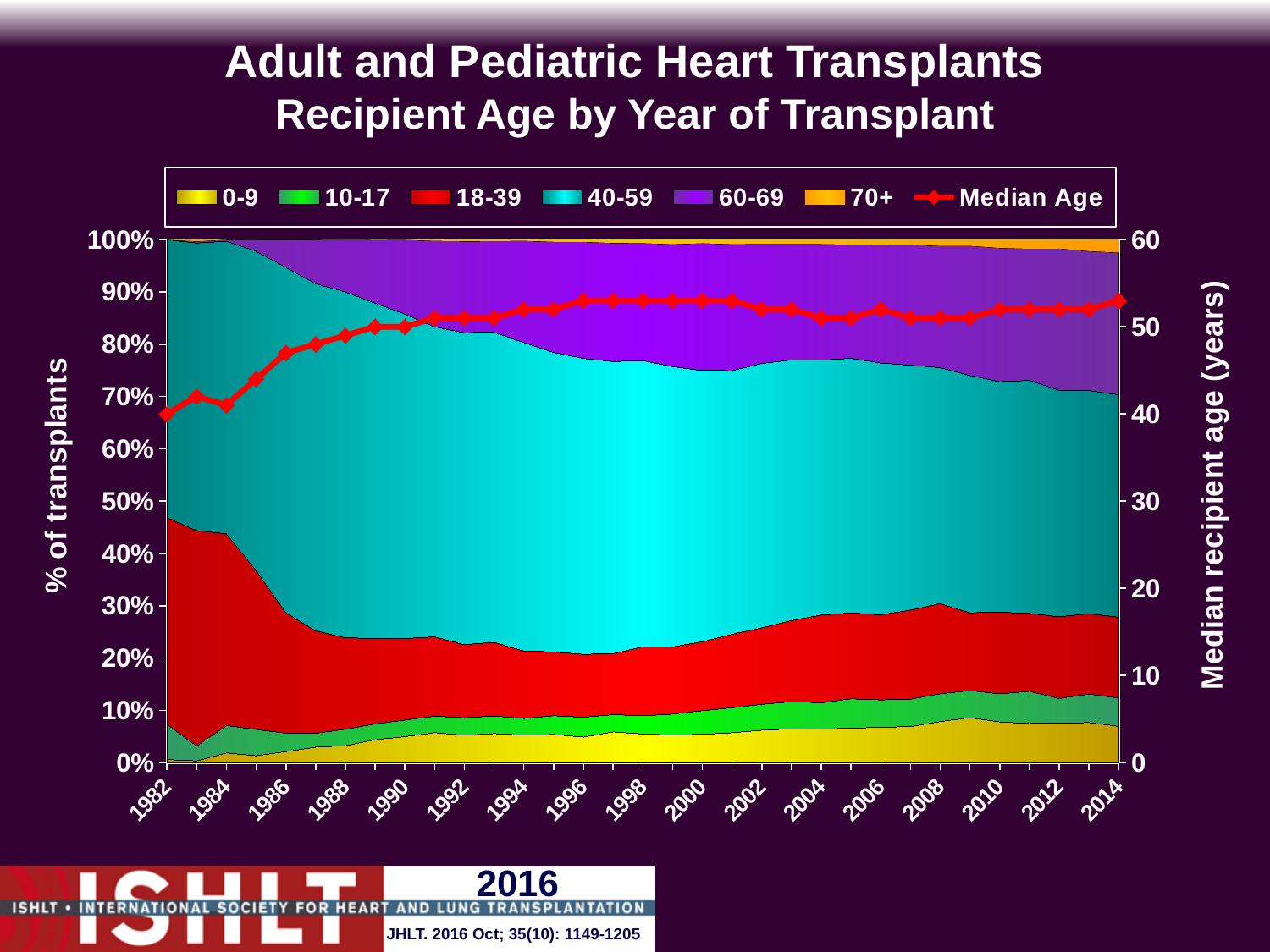
Is the median recipient age in 2014 greater or less than 50 years? greater What is the label of the right-hand vertical axis? Median recipient age (years) Does the share of transplants in the 18-39 age group rise or fall from 1982 to 2014? fall Does the median recipient age generally rise or fall from 1982 to 2014? rise Is the median recipient age in 1982 greater or less than 50 years? less What kind of chart is shown on the slide? Stacked area chart with a line for median age How many year labels are shown along the x axis? 17 Is the median recipient age in 1998 greater or less than 50 years? greater How many series does the legend list? 7 Which year has the larger median recipient age, 1982 or 2014? 2014